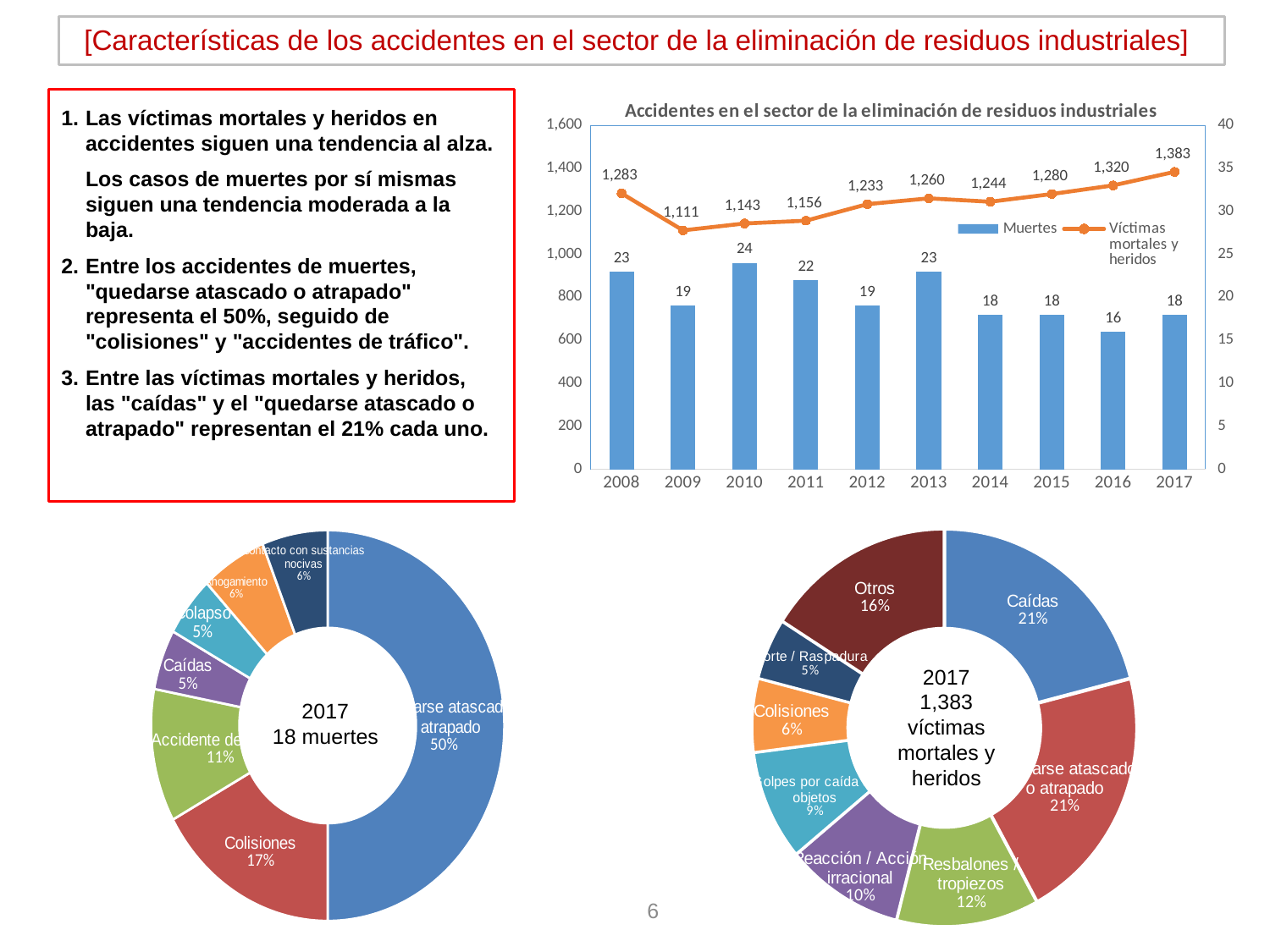
In the chart titled 'Accidentes en el sector de la eliminación de residuos industriales', how many series does the legend list? 2 In the chart titled 'Accidentes en el sector de la eliminación de residuos industriales', what is the value of Muertes for 2010? 24 In the chart titled 'Accidentes en el sector de la eliminación de residuos industriales', do the Víctimas mortales y heridos values rise or fall from 2012 to 2017? rise In the chart titled 'Accidentes en el sector de la eliminación de residuos industriales', which year has more Muertes, 2008 or 2011? 2008 In the bottom-left donut chart (2017, 18 muertes), which category has the largest share? Quedarse atascado o atrapado In the chart titled 'Accidentes en el sector de la eliminación de residuos industriales', which year has the lowest value for Muertes? 2016 In the bottom-right donut chart (2017, 1,383 víctimas mortales y heridos), what share does Resbalones y tropiezos represent? 12% In the chart titled 'Accidentes en el sector de la eliminación de residuos industriales', what is the difference between the Víctimas mortales y heridos values for 2017 and 2008? 100 In the chart titled 'Accidentes en el sector de la eliminación de residuos industriales', what is the value of Víctimas mortales y heridos for 2017? 1,383 In the bottom-left donut chart (2017, 18 muertes), what share does Colisiones represent? 17% In the chart titled 'Accidentes en el sector de la eliminación de residuos industriales', how many years are shown on the x axis? 10 In the chart titled 'Accidentes en el sector de la eliminación de residuos industriales', which year has the highest value for Víctimas mortales y heridos? 2017